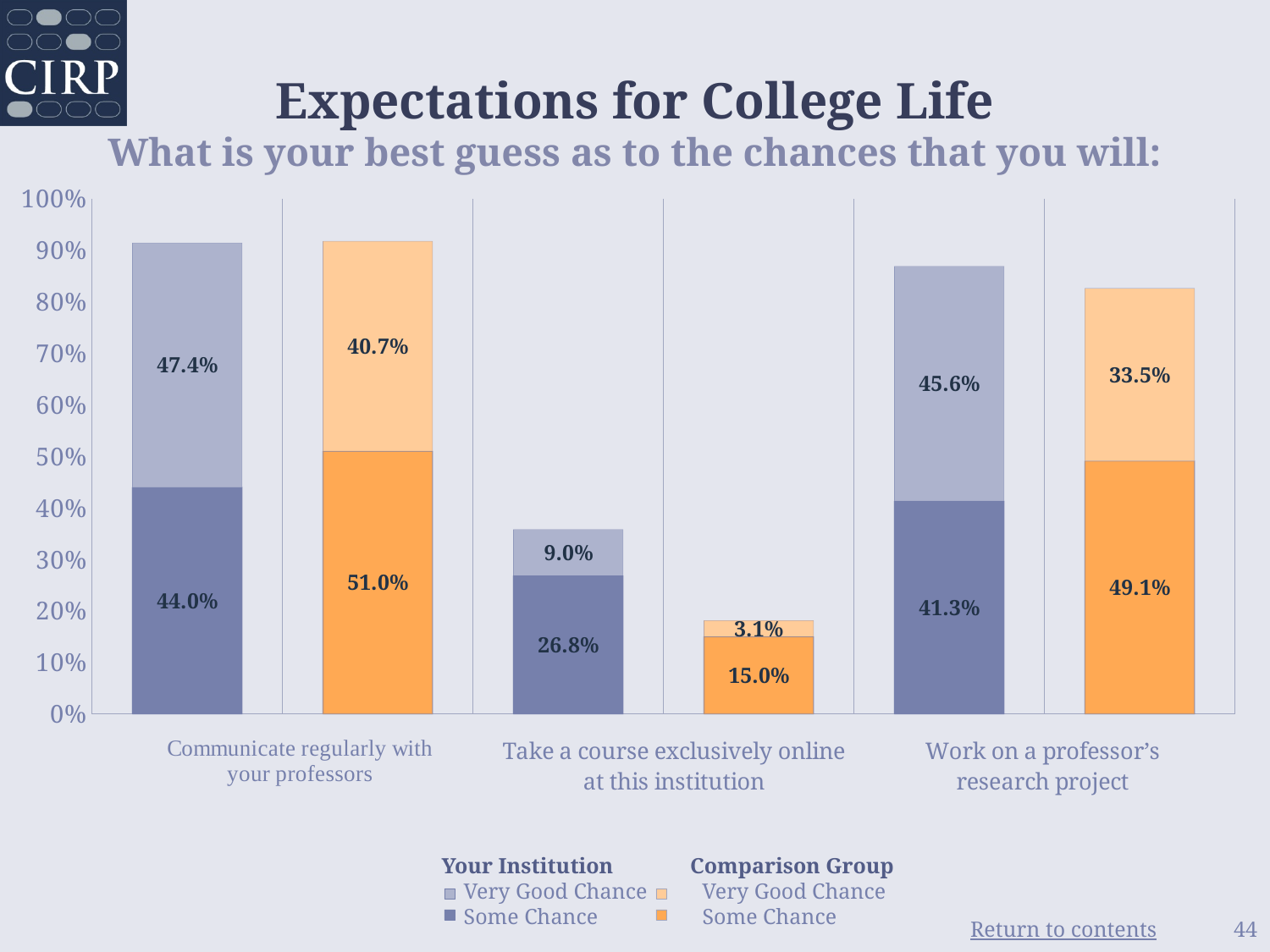
What is the Your Institution 'Very Good Chance' value for 'Communicate regularly with your professors'? 47.4% How many series does the legend list? 4 What is the Comparison Group 'Some Chance' value for 'Work on a professor's research project'? 49.1% What is the total of the Comparison Group stacked bar for 'Work on a professor's research project'? 82.6% Which category has the highest Comparison Group 'Some Chance' value? Communicate regularly with your professors What is the Comparison Group 'Very Good Chance' value for 'Take a course exclusively online at this institution'? 3.1% What is the difference between the Your Institution and Comparison Group 'Very Good Chance' values for 'Work on a professor's research project'? 12.1% Which is larger for 'Communicate regularly with your professors': the Your Institution 'Some Chance' value or the Comparison Group 'Some Chance' value? Comparison Group 'Some Chance' (51.0%) What kind of chart is shown on the slide? Stacked bar chart Which category has the lowest Your Institution 'Some Chance' value? Take a course exclusively online at this institution How many categories are shown on the x axis? 3 What is the total of the Your Institution stacked bar for 'Take a course exclusively online at this institution'? 35.8%